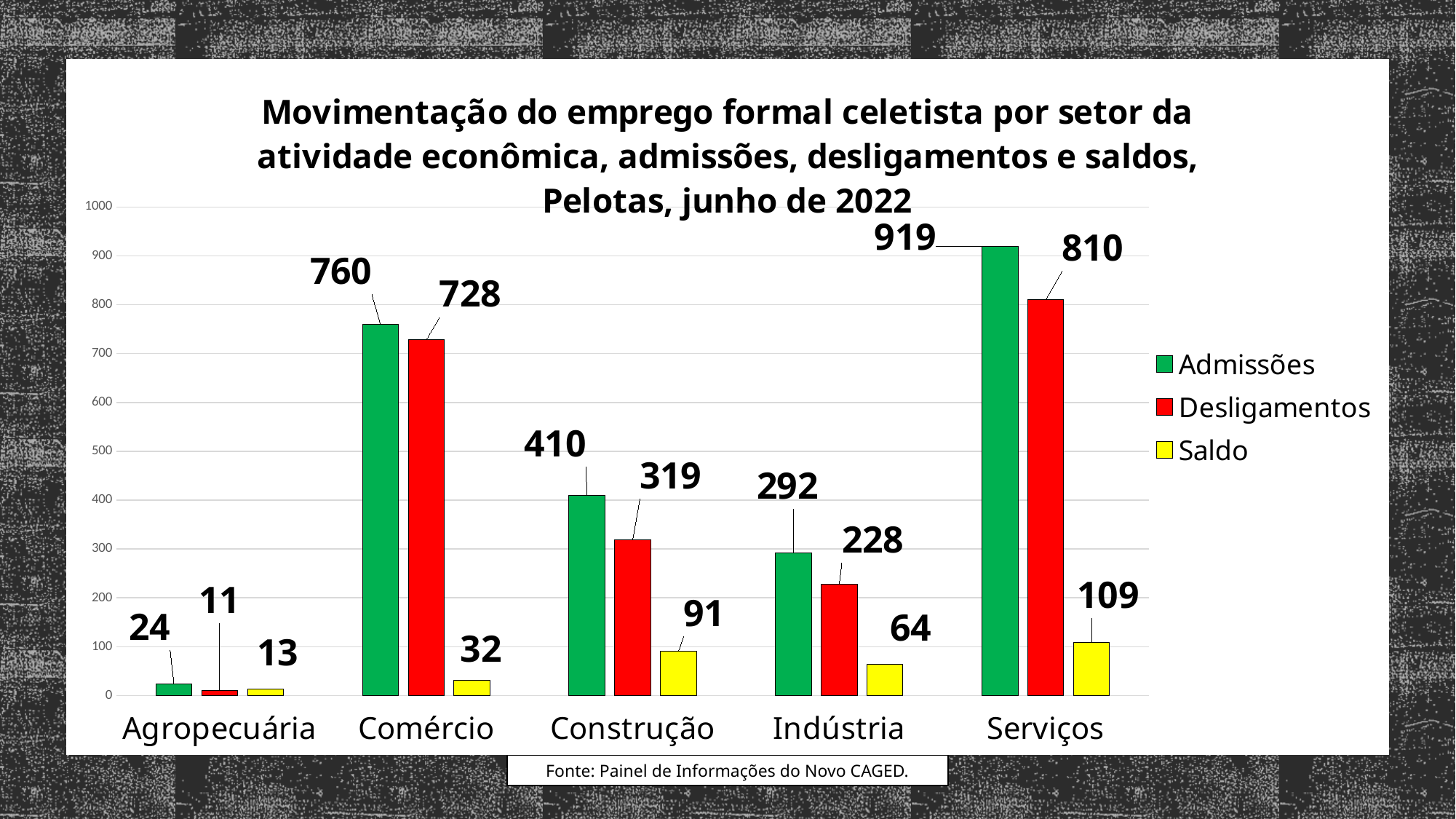
What is the Admissões value for Comércio? 760 What colour represents the Saldo series? Yellow Is the Desligamentos value for Comércio greater or less than 700? greater How many sectors are shown on the x axis? 5 What is the Desligamentos value for Serviços? 810 Which sector has the lowest Saldo value? Agropecuária What is the difference between Admissões and Desligamentos for Indústria? 64 How many series does the legend list? 3 What is the Saldo value for Construção? 91 Which is larger for Construção: Admissões or Desligamentos? Admissões What kind of chart is shown on the slide? Bar chart Which sector has the highest Admissões value? Serviços